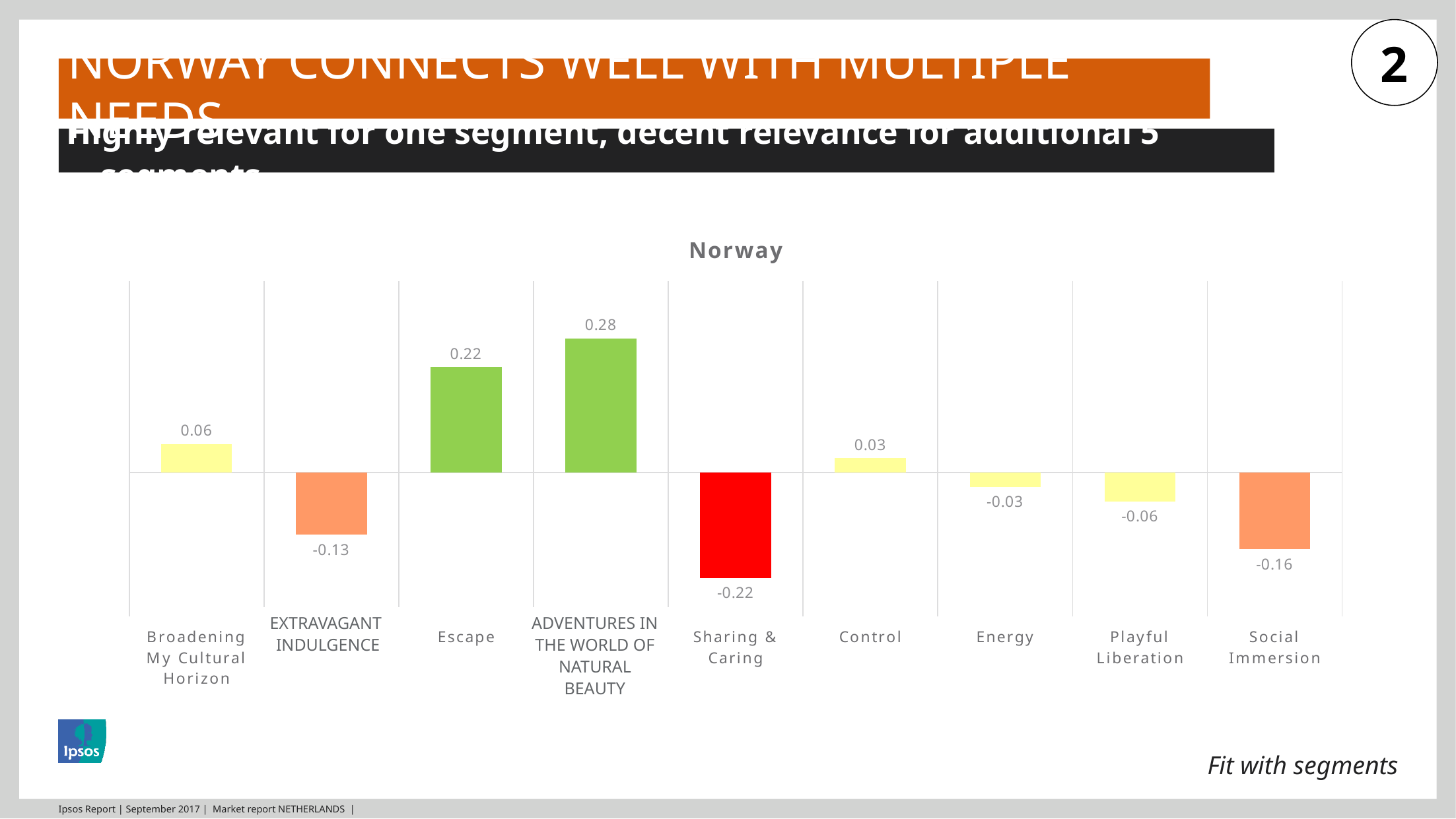
What is the value for Social Immersion? -0.16 What is the value for Escape? 0.22 What is the title of the chart? Norway What is the value for Broadening My Cultural Horizon? 0.06 What kind of chart is shown on the slide? Bar chart How many categories are shown in the chart? 9 Which is larger, the value for Extravagant Indulgence or the value for Social Immersion? Extravagant Indulgence What is the value for Control? 0.03 What is the difference between the values for Adventures in the World of Natural Beauty and Escape? 0.06 What colour is the bar for Sharing & Caring? Red Which category has the lowest value? Sharing & Caring Which category has the highest value? Adventures in the World of Natural Beauty